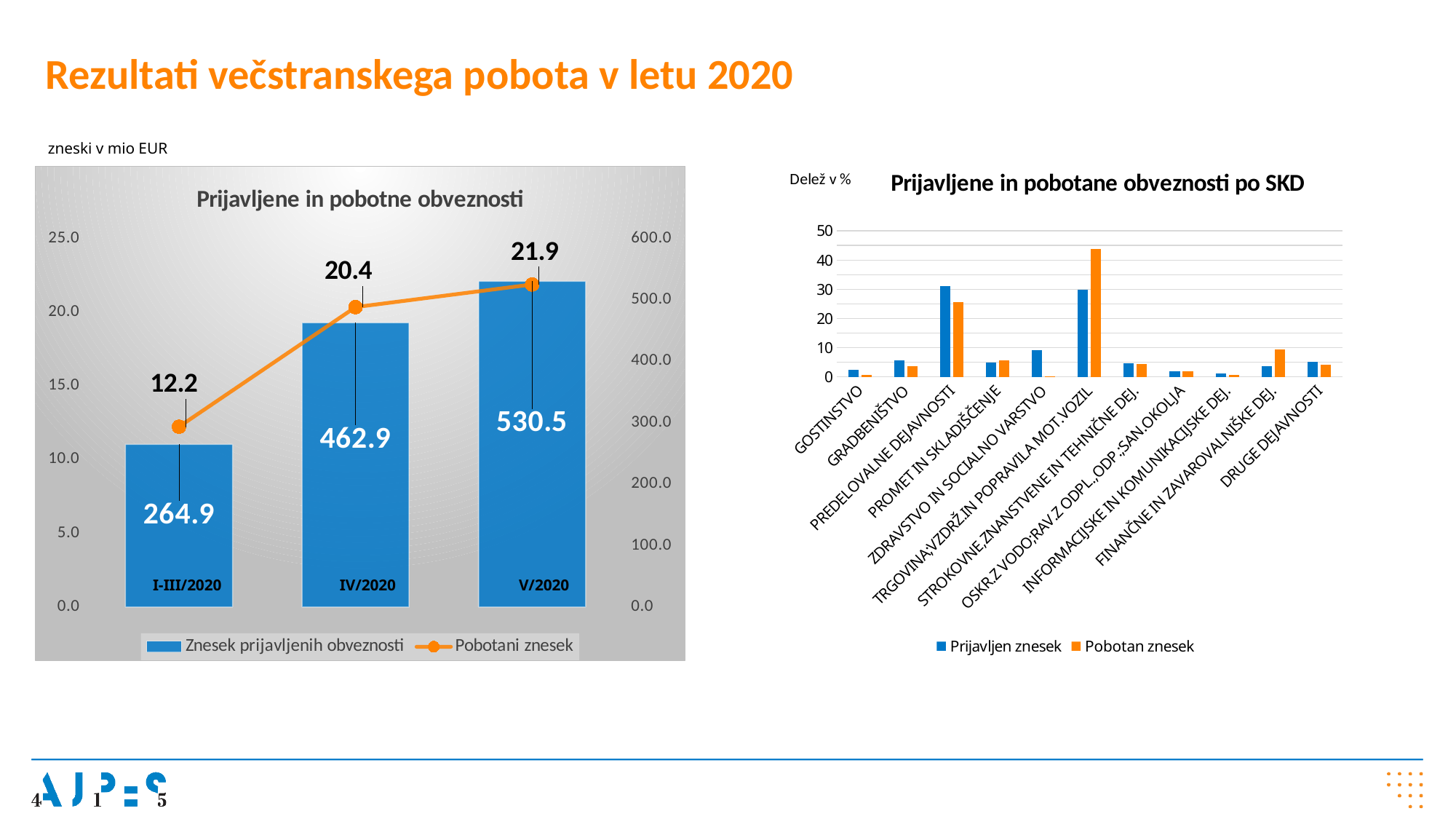
In the chart 'Prijavljene in pobotne obveznosti', does the Pobotani znesek rise or fall from I-III/2020 to V/2020? rise In the chart 'Prijavljene in pobotane obveznosti po SKD', how many series does the legend list? 2 In the chart 'Prijavljene in pobotne obveznosti', what is the Znesek prijavljenih obveznosti for IV/2020? 462.9 In the chart 'Prijavljene in pobotne obveznosti', what is the difference between the Znesek prijavljenih obveznosti for V/2020 and IV/2020? 67.6 In the chart 'Prijavljene in pobotane obveznosti po SKD', which category has the highest Pobotan znesek? TRGOVINA;VZDRŽ.IN POPRAVILA MOT.VOZIL In the chart 'Prijavljene in pobotne obveznosti', which period has the lowest Pobotani znesek? I-III/2020 In the chart 'Prijavljene in pobotne obveznosti', what is the Pobotani znesek for I-III/2020? 12.2 In the chart 'Prijavljene in pobotne obveznosti', what is the Pobotani znesek for V/2020? 21.9 In the chart 'Prijavljene in pobotne obveznosti', how many periods are shown on the x axis? 3 In the chart 'Prijavljene in pobotane obveznosti po SKD', is the Pobotan znesek for TRGOVINA;VZDRŽ.IN POPRAVILA MOT.VOZIL greater or less than 40? greater In the chart 'Prijavljene in pobotne obveznosti', which period has the highest Znesek prijavljenih obveznosti? V/2020 In the chart 'Prijavljene in pobotane obveznosti po SKD', how many categories are shown on the x axis? 11